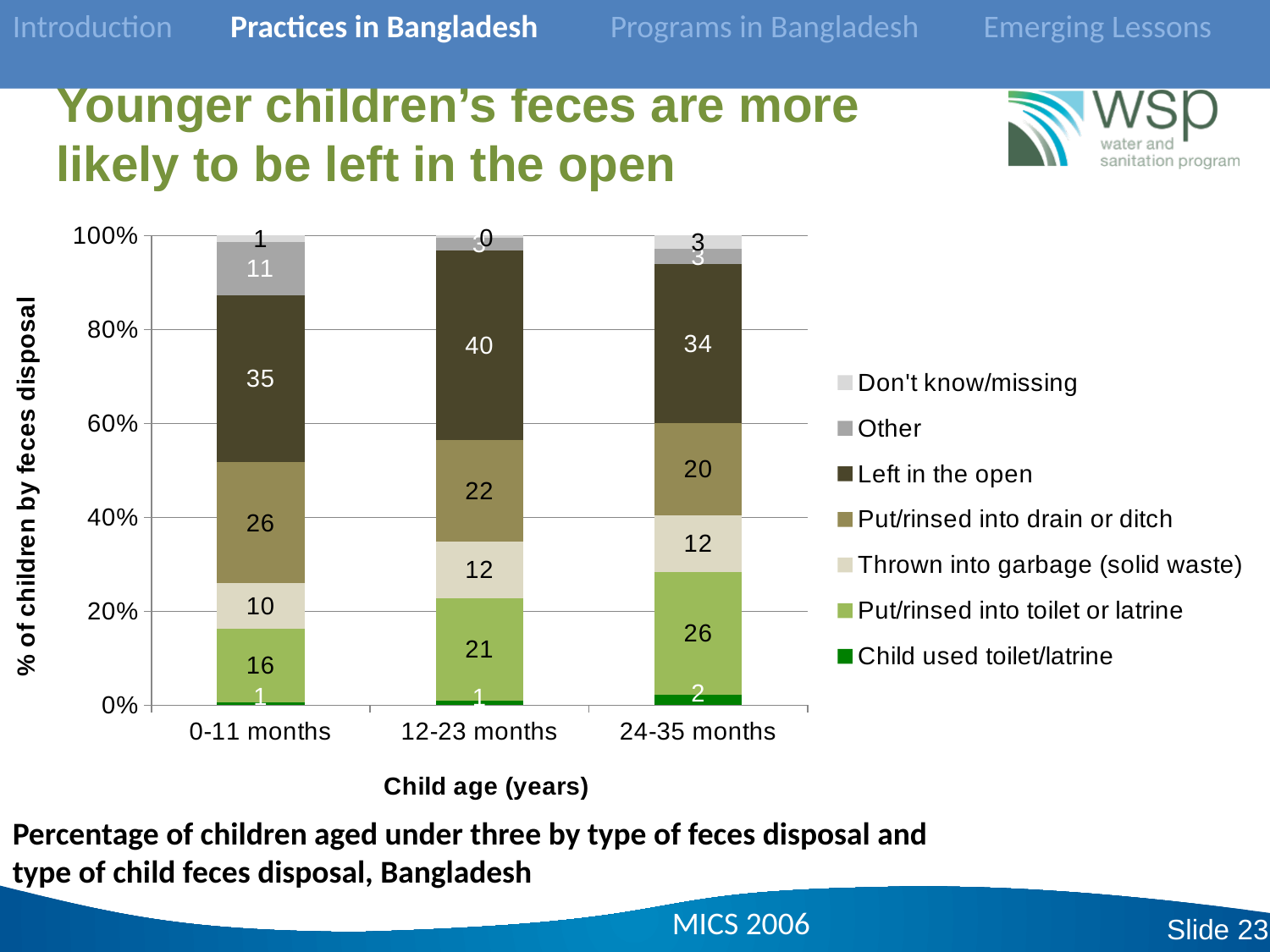
Which is larger, the "Put/rinsed into drain or ditch" value for 0-11 months or for 12-23 months? 0-11 months How many age groups are shown on the x axis? 3 Which age group has the lowest value for "Put/rinsed into toilet or latrine"? 0-11 months What is the difference between the "Left in the open" values for the 12-23 months and 24-35 months groups? 6 Which age group has the highest value for "Left in the open"? 12-23 months What is the value for "Put/rinsed into toilet or latrine" for the 24-35 months group? 26 Does the value for "Put/rinsed into toilet or latrine" rise or fall as child age increases? Rises What kind of chart is shown on the slide? Stacked bar chart How many series does the legend list? 7 What is the value for "Other" for the 0-11 months group? 11 What is the value for "Left in the open" for the 12-23 months group? 40 What is the value for "Thrown into garbage (solid waste)" for the 0-11 months group? 10